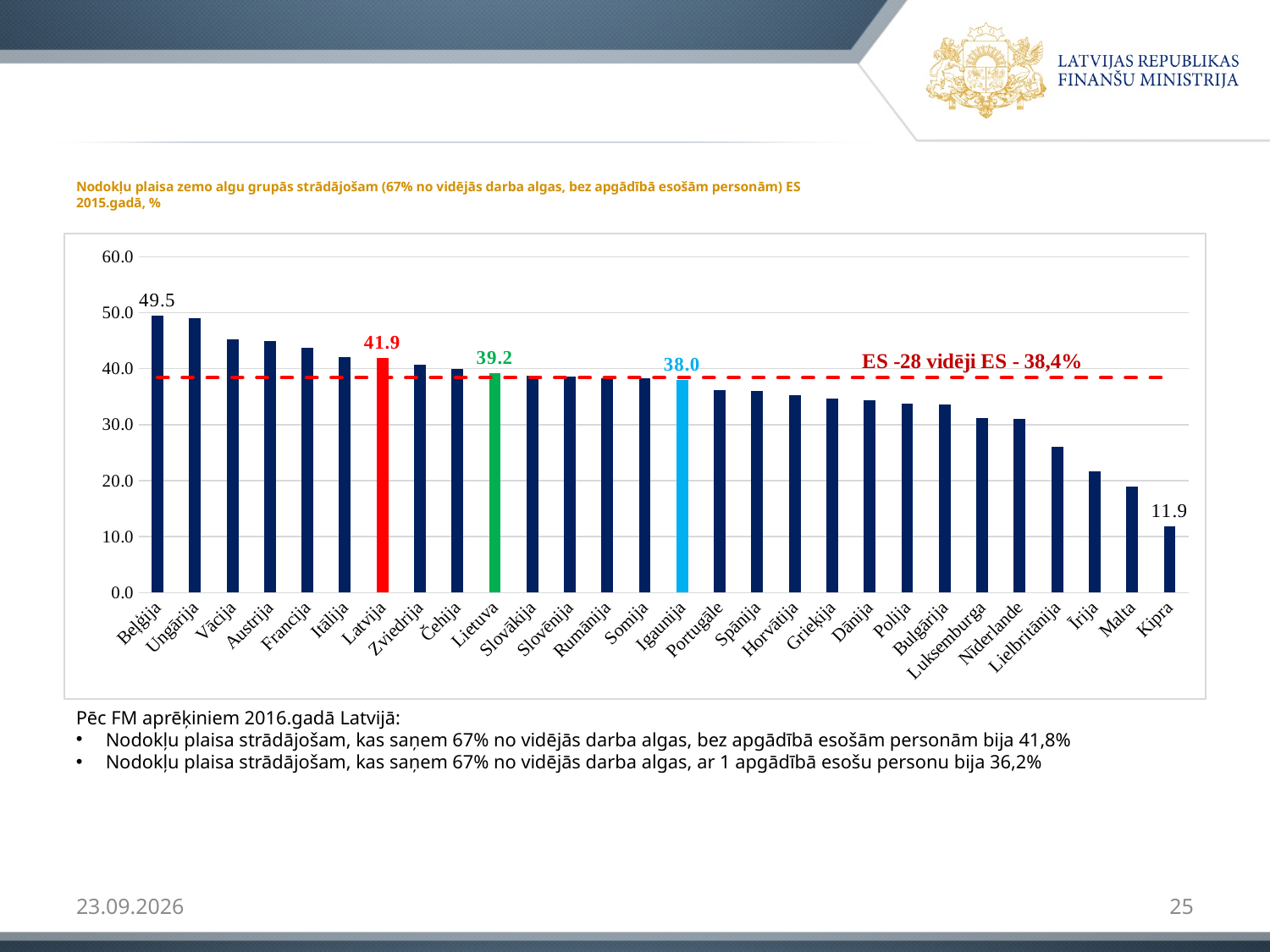
What is the ES-28 average value shown by the dashed line? 38,4% What kind of chart is this? bar chart Is the value for Malta greater or less than 20.0? less What is the value for Igaunija? 38.0 What is the difference between the values for Latvija and Lietuva? 2.7 Which country has the lowest value? Kipra How many countries are shown on the x axis? 28 What is the value for Lietuva? 39.2 What is the value for Latvija? 41.9 What is the difference between the values for Beļģija and Kipra? 37.6 Which country has the highest value? Beļģija Which is larger, the value for Latvija or the value for Igaunija? Latvija